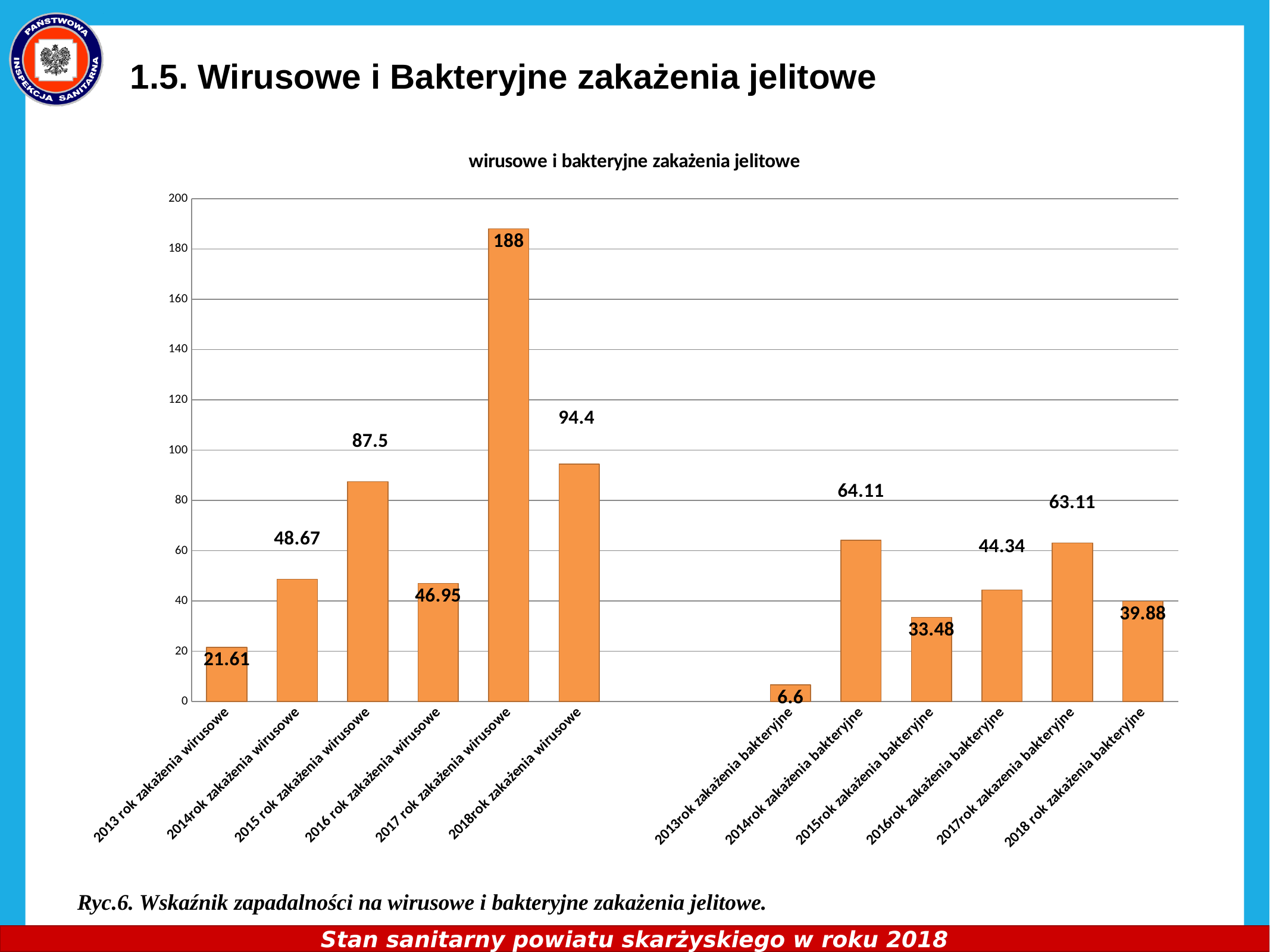
What is the difference between the values for "2017 rok zakażenia wirusowe" and "2018rok zakażenia wirusowe"? 93.6 What is the value for "2015 rok zakażenia wirusowe"? 87.5 Which category has the lowest value? 2013rok zakażenia bakteryjne Which is larger: the value for "2014rok zakażenia bakteryjne" or "2017rok zakażenia bakteryjne"? 2014rok zakażenia bakteryjne What kind of chart is shown on the slide? bar chart Which category has the highest value? 2017 rok zakażenia wirusowe What is the value for "2017 rok zakażenia wirusowe"? 188 Is the value for "2018rok zakażenia wirusowe" greater or less than 80? greater What is the title of the chart? wirusowe i bakteryjne zakażenia jelitowe What is the value for "2013rok zakażenia bakteryjne"? 6.6 What is the value for "2018 rok zakażenia bakteryjne"? 39.88 How many bars are plotted in the chart? 12